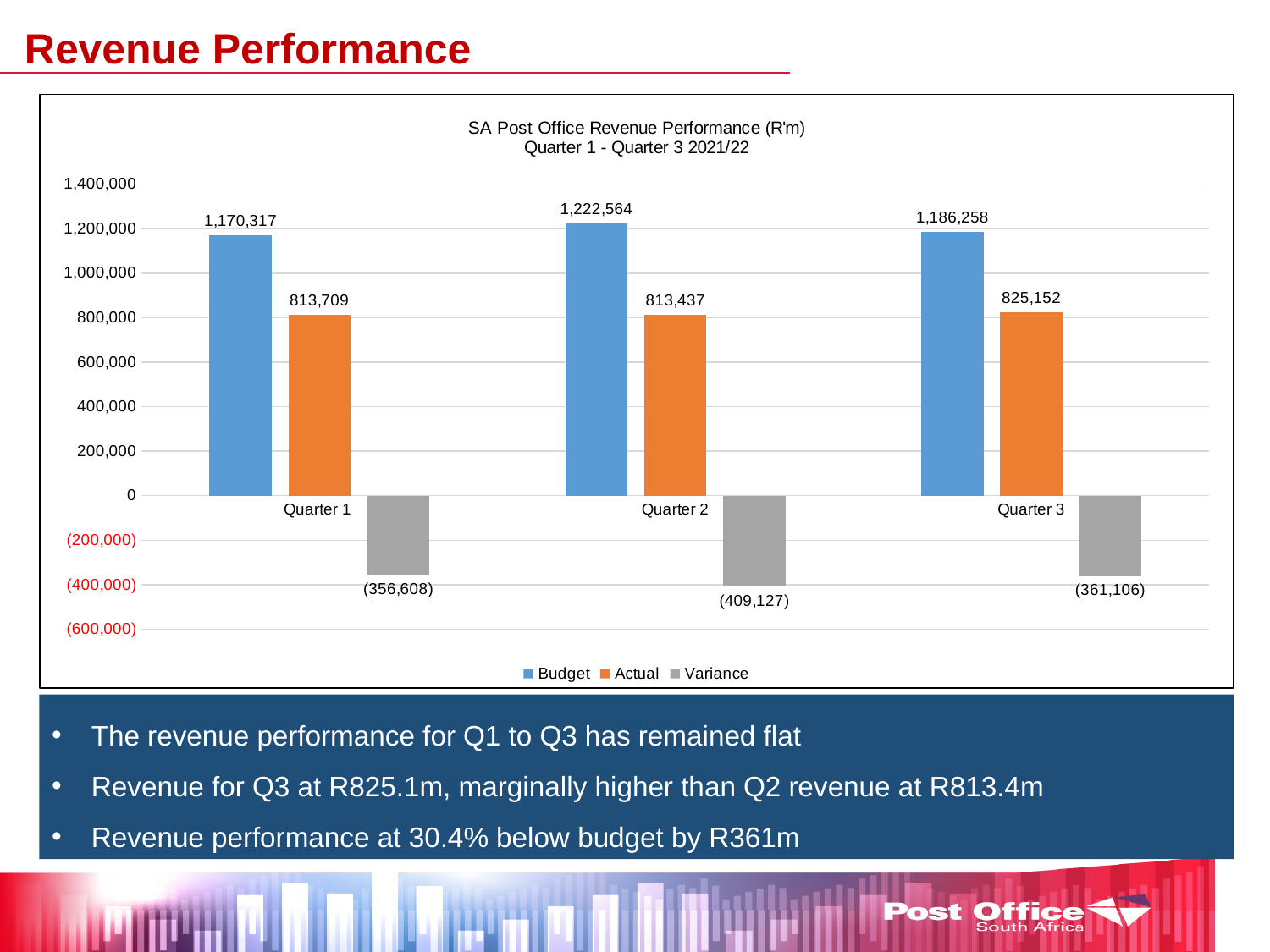
What is the Actual value for Quarter 3? 825,152 Which quarter has the lowest Actual value? Quarter 2 Is the Budget value for Quarter 3 greater or less than 1,000,000? greater What is the difference between the Budget and Actual values for Quarter 1? 356,608 What is the Variance value for Quarter 1? (356,608) Which quarter has the highest Budget value? Quarter 2 What kind of chart is shown on the slide? Bar chart How many series does the legend list? 3 Is the Actual value for Quarter 2 larger than the Actual value for Quarter 3? No What is the Budget value for Quarter 2? 1,222,564 What is the title of the chart? SA Post Office Revenue Performance (R'm) Quarter 1 - Quarter 3 2021/22 How many quarters are shown on the x axis? 3